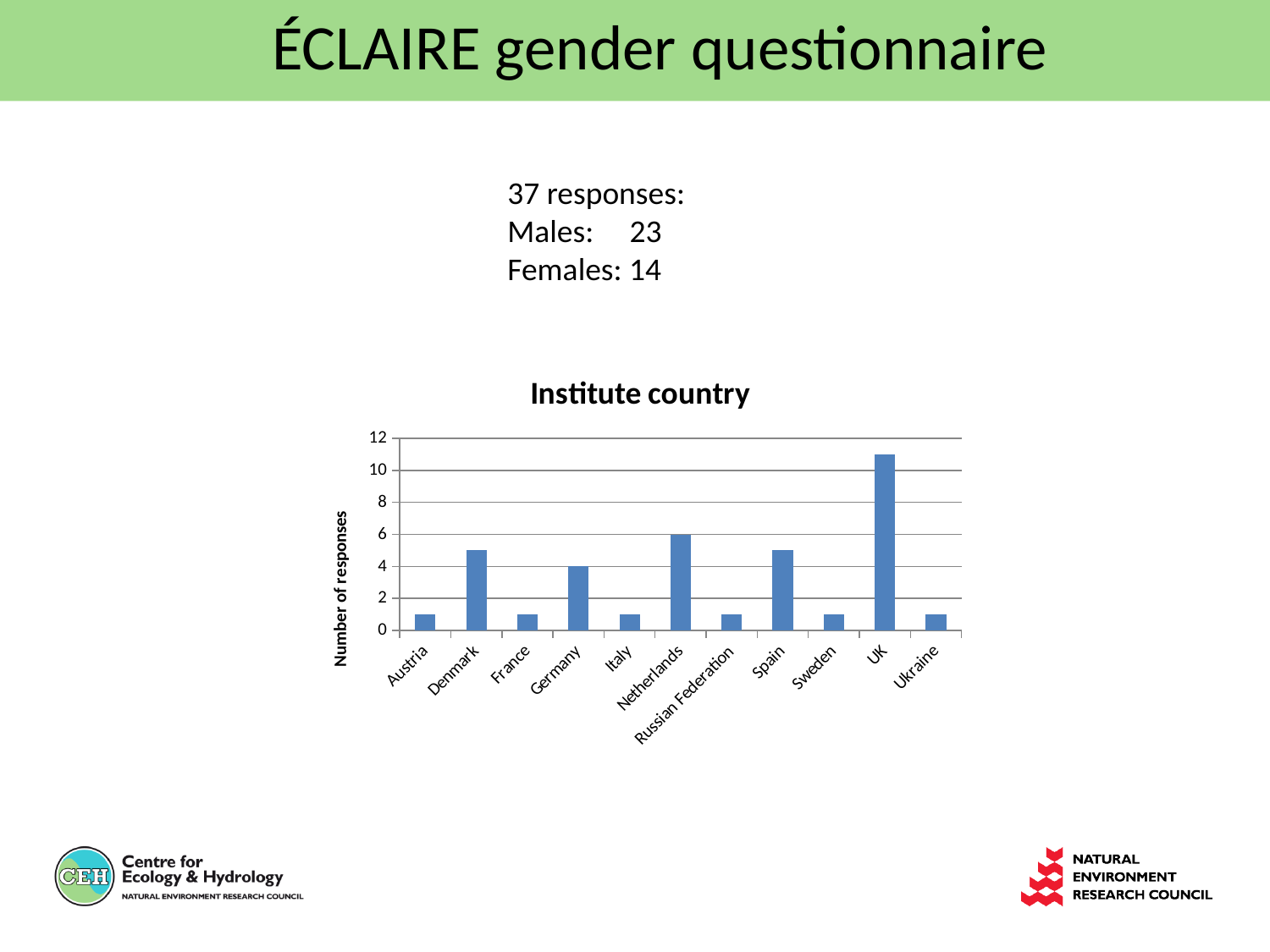
What is the number of responses for Germany? 4 How many countries are shown on the x axis of the chart? 11 What type of chart is shown on the slide? bar chart Is the number of responses for Denmark greater or less than 4? greater What is the difference in number of responses between Netherlands and Germany? 2 What is the label on the vertical axis of the chart? Number of responses Is the number of responses for Austria greater or less than 2? less Which has more responses, Netherlands or Germany? Netherlands Is the number of responses for UK greater or less than 10? greater What is the title of the chart? Institute country What is the number of responses for Netherlands? 6 Which country has the highest number of responses? UK